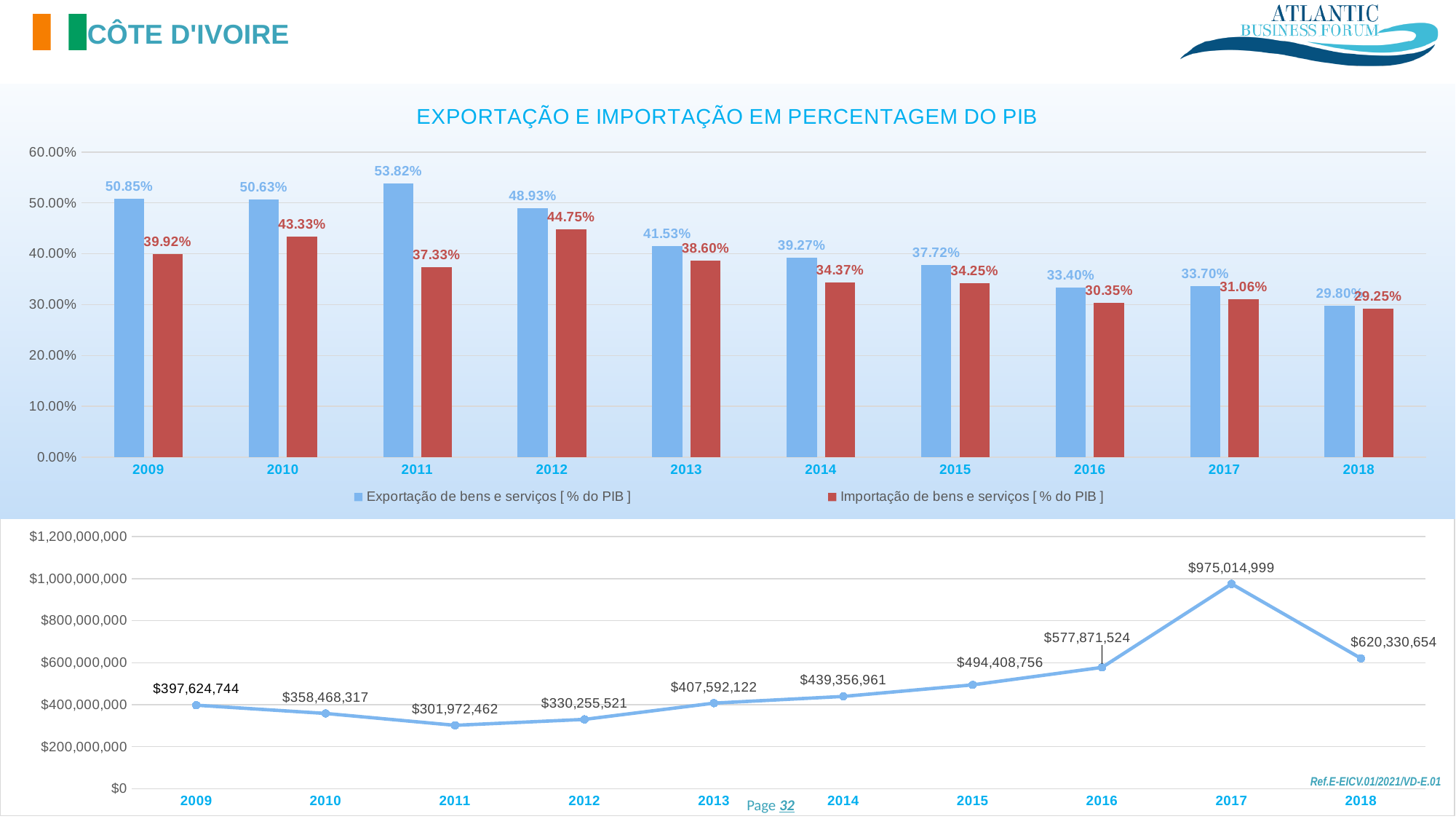
In the top chart 'EXPORTAÇÃO E IMPORTAÇÃO EM PERCENTAGEM DO PIB', which is larger in 2010: Exportação or Importação? Exportação In the bottom line chart, how many years are plotted on the x axis? 10 In the top chart 'EXPORTAÇÃO E IMPORTAÇÃO EM PERCENTAGEM DO PIB', what is the difference between the Exportação and Importação values for 2012? 4.18% In the bottom line chart, what is the value for 2017? $975,014,999 In the top chart 'EXPORTAÇÃO E IMPORTAÇÃO EM PERCENTAGEM DO PIB', what kind of chart is it? Bar chart In the top chart 'EXPORTAÇÃO E IMPORTAÇÃO EM PERCENTAGEM DO PIB', which year has the lowest Importação value? 2018 In the top chart 'EXPORTAÇÃO E IMPORTAÇÃO EM PERCENTAGEM DO PIB', what is the value of Importação de bens e serviços for 2012? 44.75% In the top chart 'EXPORTAÇÃO E IMPORTAÇÃO EM PERCENTAGEM DO PIB', which year has the highest Exportação value? 2011 In the top chart 'EXPORTAÇÃO E IMPORTAÇÃO EM PERCENTAGEM DO PIB', how many series does the legend list? 2 In the top chart 'EXPORTAÇÃO E IMPORTAÇÃO EM PERCENTAGEM DO PIB', what is the value of Exportação de bens e serviços for 2011? 53.82% In the bottom line chart, what is the difference between the values for 2017 and 2018? $354,684,345 In the bottom line chart, which year has the lowest value? 2011